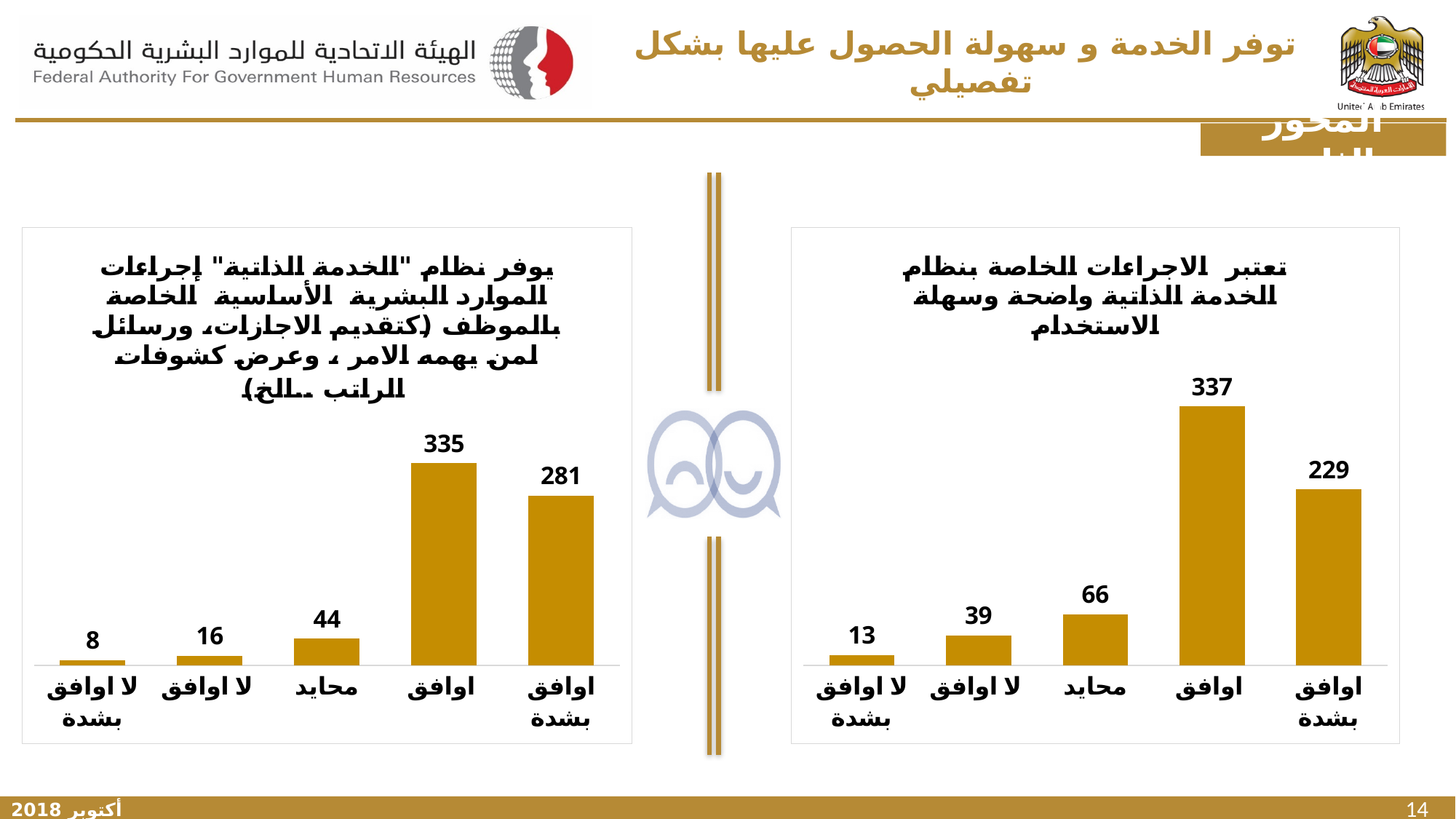
In the left chart, what is the value for لا اوافق بشدة? 8 In the right chart, which category has the highest value? اوافق What type of chart is the right chart? bar chart In the right chart, what is the difference between the values for لا اوافق and لا اوافق بشدة? 26 In the right chart, which is larger: the value for محايد or the value for لا اوافق? محايد What is the total of all values in the right chart? 684 How many categories are shown in the left chart? 5 In the left chart (يوفر نظام "الخدمة الذاتية" إجراءات الموارد البشرية الأساسية), what is the value for اوافق? 335 In the right chart (تعتبر الاجراءات الخاصة بنظام الخدمة الذاتية واضحة وسهلة الاستخدام), what is the value for اوافق بشدة? 229 In the left chart, which category has the lowest value? لا اوافق بشدة In the left chart, what is the difference between the values for اوافق and اوافق بشدة? 54 In the right chart, what is the value for محايد? 66